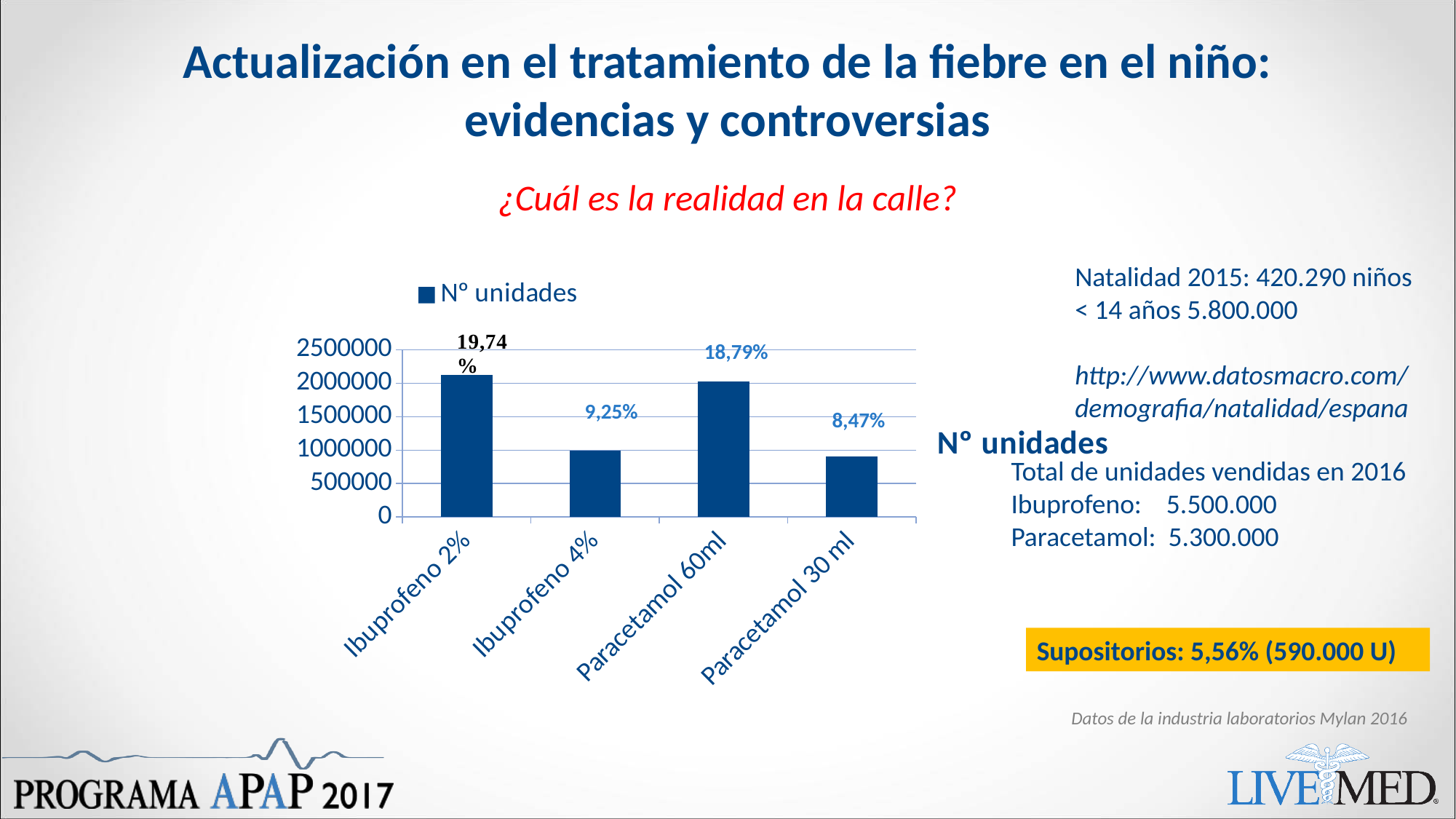
Is the value for Ibuprofeno 4% greater or less than 1500000? less What percentage label is shown on the Ibuprofeno 2% bar? 19,74% Which has more units, Ibuprofeno 4% or Paracetamol 60ml? Paracetamol 60ml Which category has the lowest number of units? Paracetamol 30 ml What percentage label is shown on the Paracetamol 30 ml bar? 8,47% How many categories are shown on the x axis of the chart? 4 Which category has the highest number of units? Ibuprofeno 2% What kind of chart is shown on the slide? Bar chart What is the difference between the percentage labels for Ibuprofeno 2% and Ibuprofeno 4%? 10,49% What percentage label is shown on the Paracetamol 60ml bar? 18,79% How many series does the chart legend list? 1 What percentage label is shown on the Ibuprofeno 4% bar? 9,25%